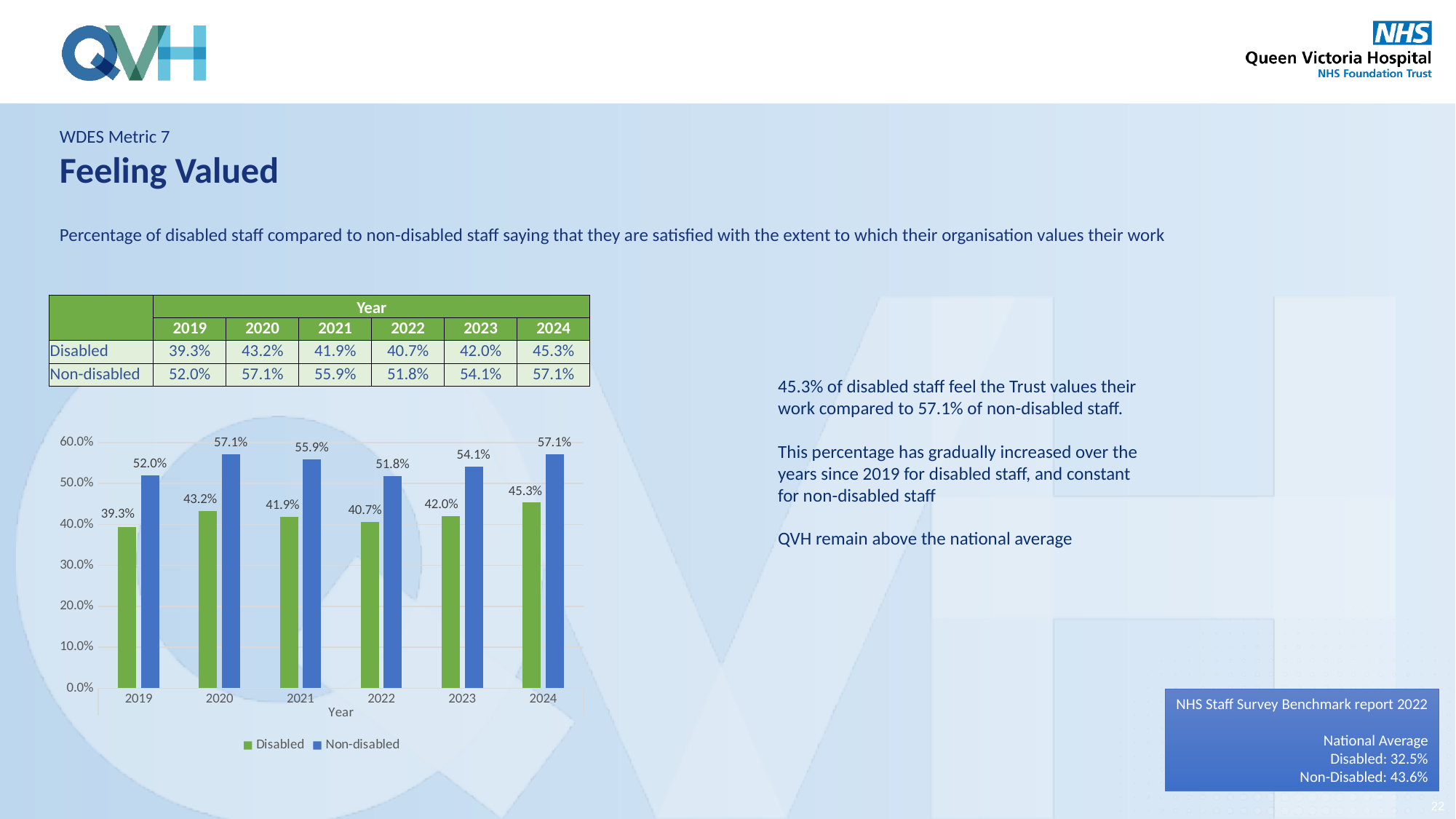
What colour are the Non-disabled bars in the chart? Blue What is the value for Disabled staff in 2019? 39.3% What is the value for Disabled staff in 2024? 45.3% In which year is the Disabled series lowest? 2019 Which is larger in 2021, the Disabled value or the Non-disabled value? Non-disabled What kind of chart is shown on the slide? Bar chart How many series does the chart legend list? 2 What is the difference between Non-disabled and Disabled staff in 2024? 11.8% Is the value for Non-disabled staff in 2020 greater or less than 50.0%? greater How many years are shown on the x axis of the chart? 6 In which year is the Disabled series highest? 2024 What is the value for Non-disabled staff in 2022? 51.8%